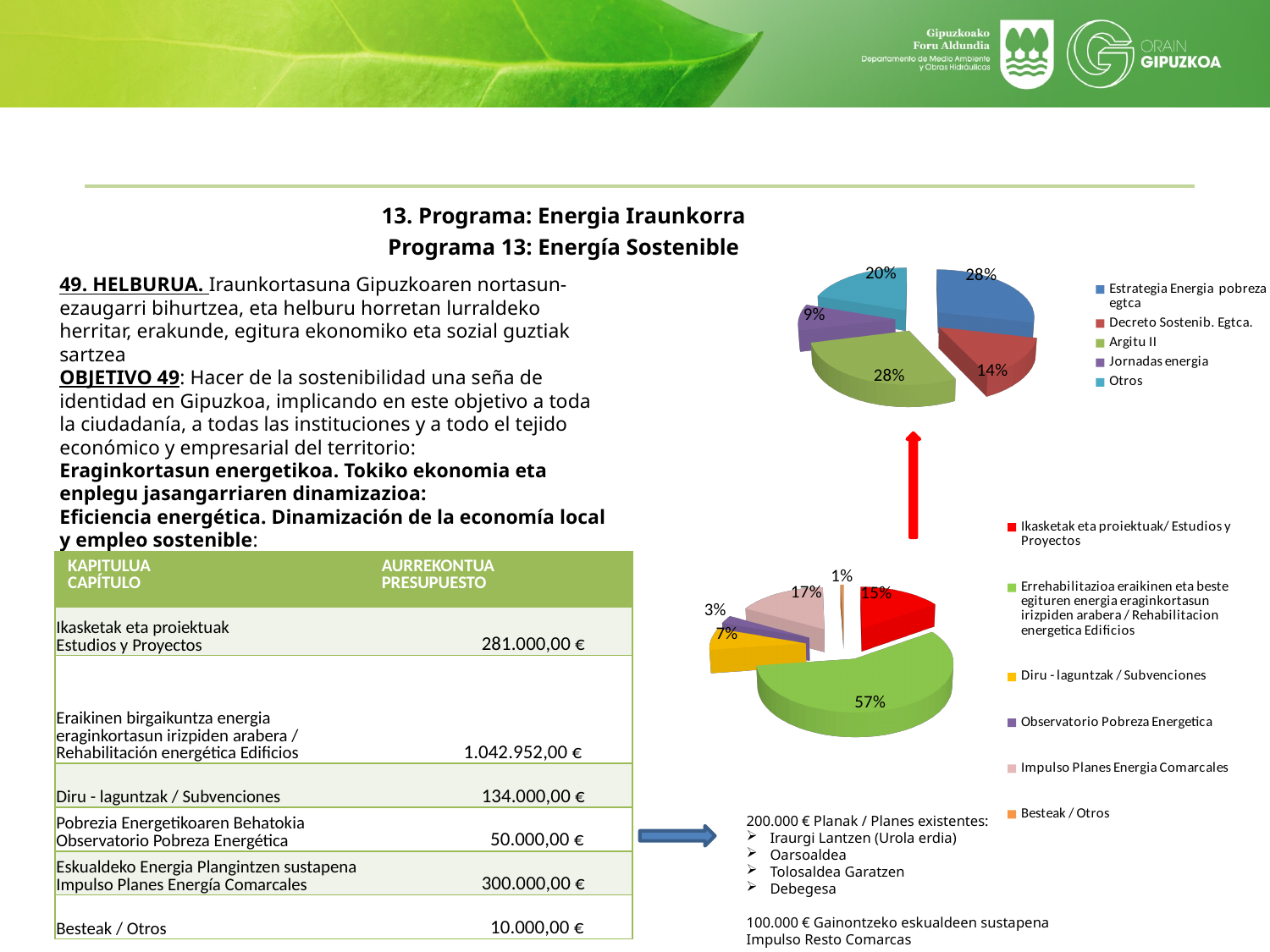
In the top pie chart, what percentage is shown for Decreto Sostenib. Egtca.? 14% In the top pie chart, which is larger: Otros or Decreto Sostenib. Egtca.? Otros In the bottom pie chart, what is the difference in percentage points between the Rehabilitacion energetica Edificios slice and the Ikasketak eta proiektuak / Estudios y Proyectos slice? 42 percentage points In the top pie chart, which category has the smallest share? Jornadas energia How many entries does the legend of the bottom pie chart list? 6 In the bottom pie chart, what percentage is shown for Impulso Planes Energia Comarcales? 17% In the bottom pie chart, which category has the smallest share? Besteak / Otros In the top pie chart, what percentage is shown for Otros? 20% In the top pie chart, what percentage is shown for Jornadas energia? 9% How many slices does the top pie chart have? 5 What kind of chart is the bottom chart on the slide? Pie chart In the bottom pie chart, which category has the largest share? Errehabilitazioa eraikinen eta beste egituren energia eraginkortasun irizpiden arabera / Rehabilitacion energetica Edificios